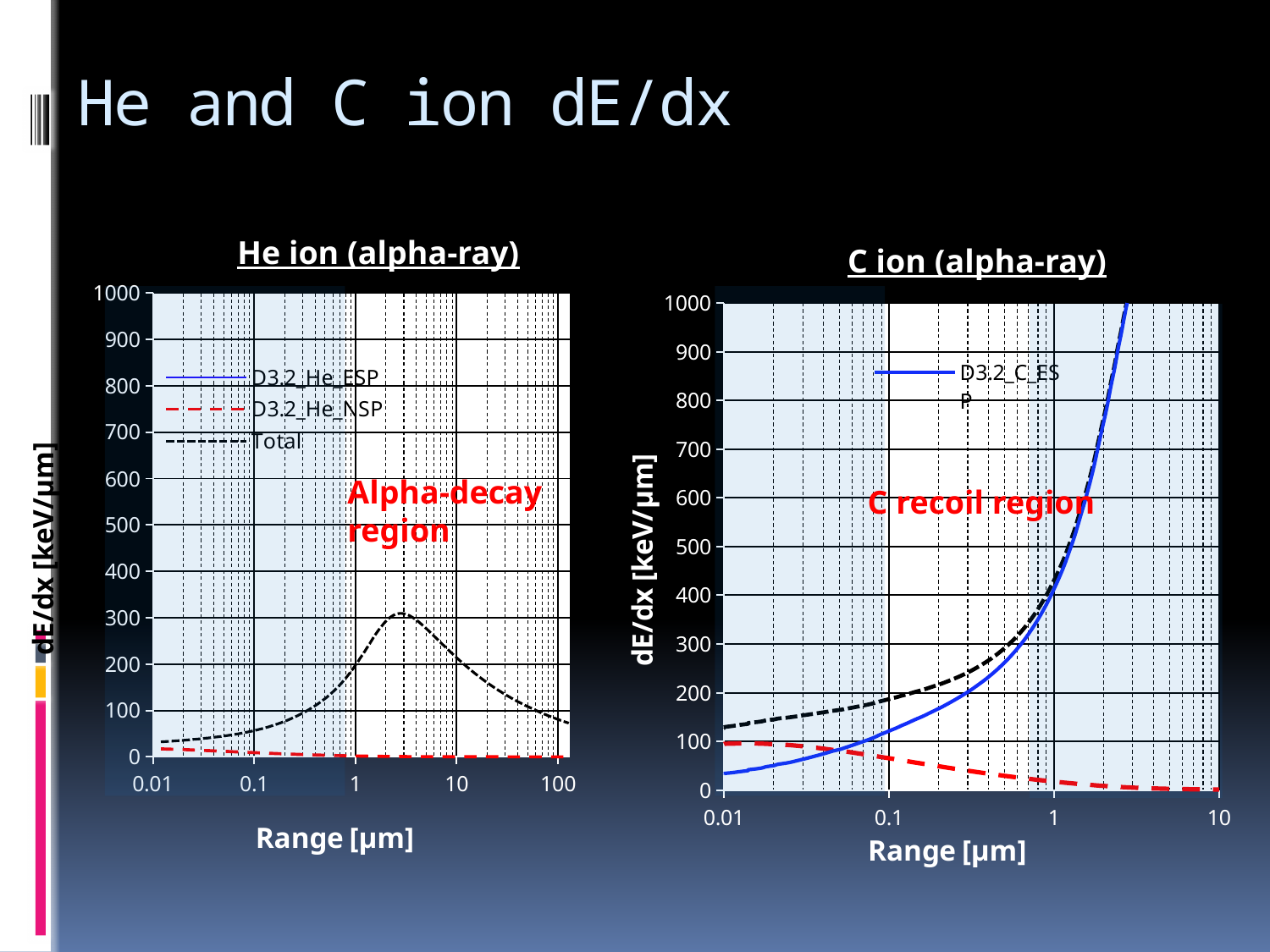
In the He ion (alpha-ray) chart, at a range of 1 µm, which is larger: the Total series or the D3.2_He_NSP series? Total What kind of chart is the He ion (alpha-ray) chart? line chart In the He ion (alpha-ray) chart, which series is drawn as a red dashed line? D3.2_He_NSP In the C ion (alpha-ray) chart, is the value of D3.2_C_ESP at a range of 0.01 µm greater or less than 100? less In the He ion (alpha-ray) chart, is the value of D3.2_He_NSP at a range of 10 µm greater or less than 100? less In the C ion (alpha-ray) chart, does the D3.2_C_ESP series rise or fall as range increases? rise What is the highest tick value shown on the y-axis of the He ion (alpha-ray) chart? 1000 In the C ion (alpha-ray) chart, at a range of 0.01 µm, which is larger: the black dashed series or the blue D3.2_C_ESP series? the black dashed series In the C ion (alpha-ray) chart, does the red dashed series rise or fall as range increases? fall How many series does the legend of the He ion (alpha-ray) chart list? 3 In the He ion (alpha-ray) chart, is the peak value of the Total series greater or less than 200? greater What is the x-axis title of the C ion (alpha-ray) chart? Range [µm]